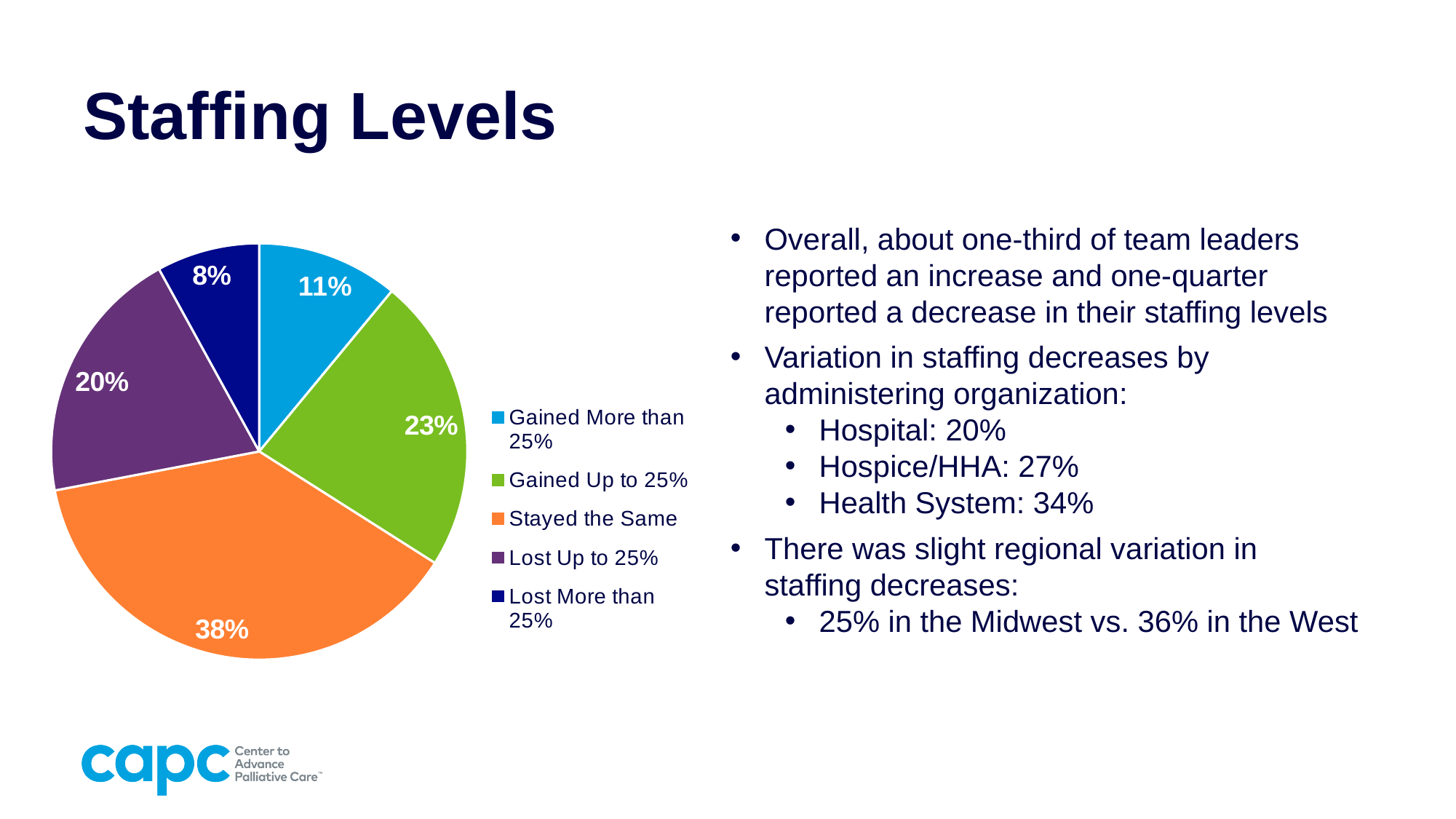
What share of the pie is labelled "Stayed the Same"? 38% Which is larger: "Gained Up to 25%" or "Lost Up to 25%"? Gained Up to 25% What is the combined share of the two "Gained" categories? 34% What is the difference in percentage points between "Stayed the Same" and "Lost Up to 25%"? 18 What percentage is shown for "Lost More than 25%"? 8% What colour is the "Stayed the Same" slice? orange Which category has the largest slice of the pie? Stayed the Same How many slices does the pie chart have? 5 Which category has the smallest slice of the pie? Lost More than 25% What percentage is shown for "Gained More than 25%"? 11% What percentage is shown for "Gained Up to 25%"? 23% What kind of chart is shown on the slide? pie chart